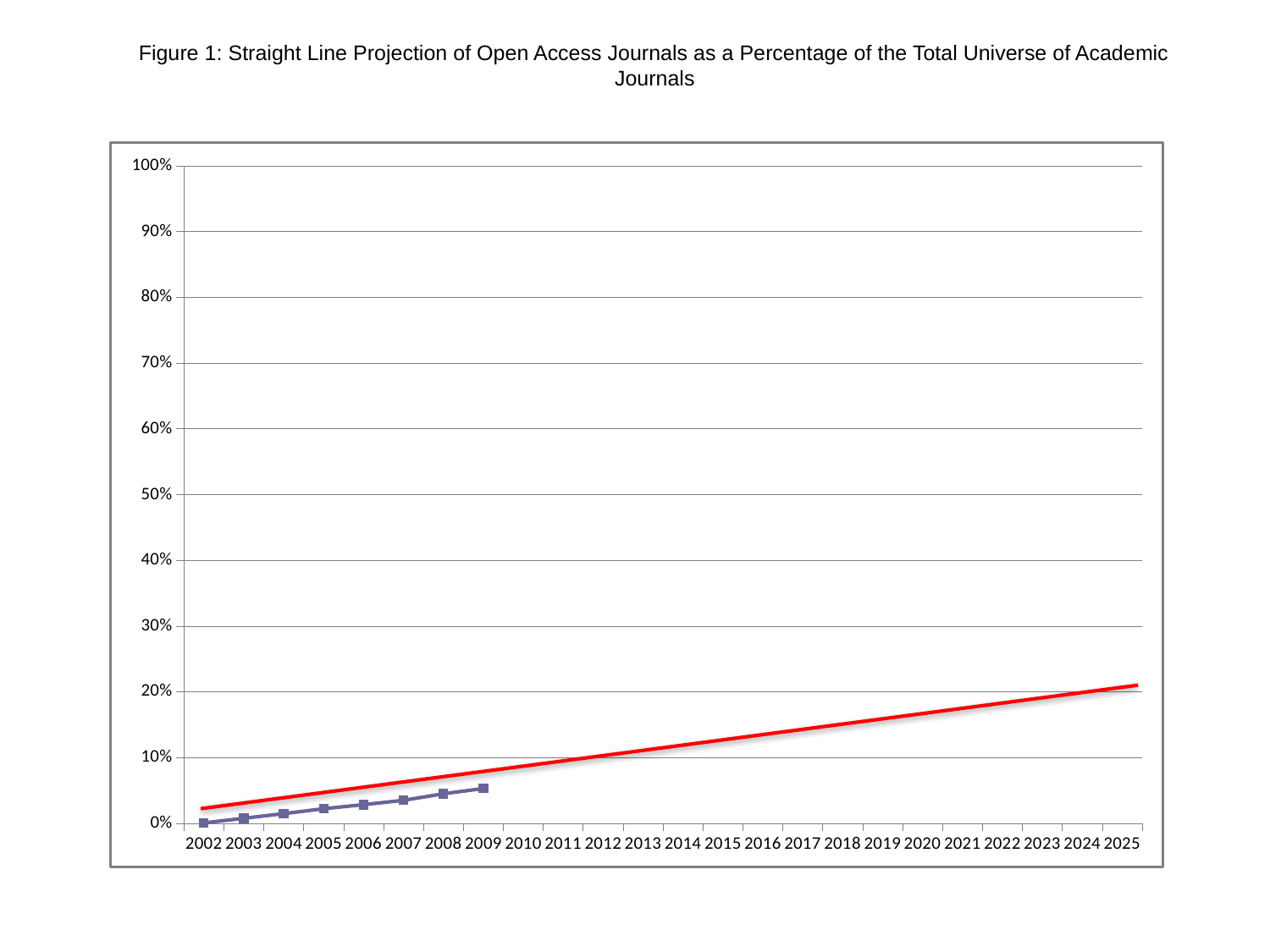
Is the value of the blue marked line in 2009 greater or less than 10%? less Do the values of the blue marked line rise or fall from 2002 to 2009? rise Is the value of the red projection line in 2025 greater or less than 30%? less How many data points are plotted on the blue marked line? 8 What kind of chart is shown on the slide? line chart Does the red projection line rise or fall from 2002 to 2025? rise What is the title of the chart? Figure 1: Straight Line Projection of Open Access Journals as a Percentage of the Total Universe of Academic Journals How many years are labelled along the x axis? 24 Is the value of the red projection line in 2025 greater or less than 10%? greater In which year is the blue marked line at its highest value? 2009 In which year is the blue marked line at its lowest value? 2002 What is the first year shown on the x axis? 2002